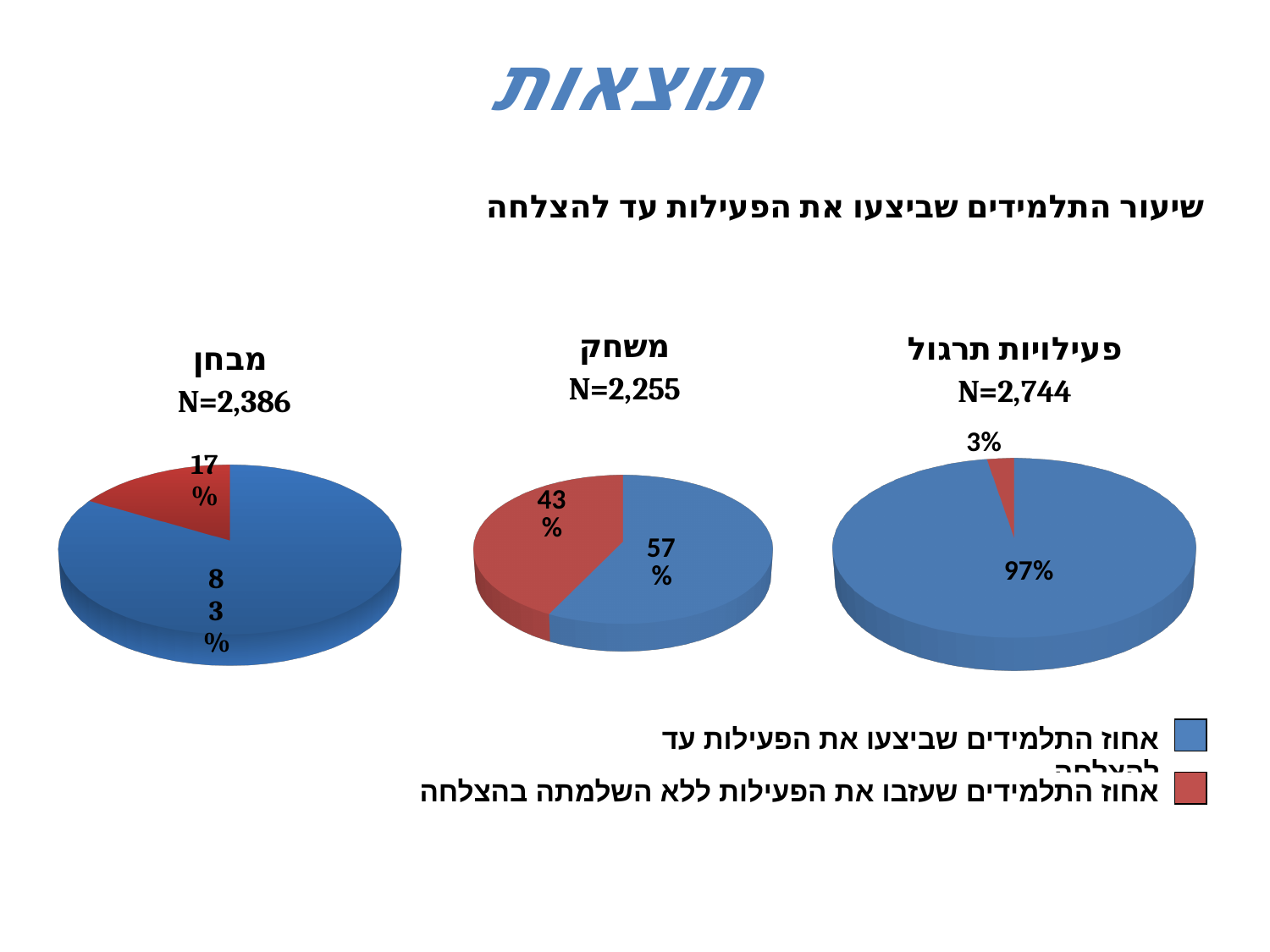
What is the sample size (N) shown for the "משחק" pie chart? N=2,255 In the "מבחן" pie chart, what share of students completed the activity successfully (blue slice)? 83% In the "משחק" pie chart, what share of students abandoned the activity (red slice)? 43% In the "פעילויות תרגול" pie chart, what share of students abandoned the activity (red slice)? 3% Which of the three pie charts shows the highest share of students who completed the activity successfully? פעילויות תרגול What is the difference between the blue and red slices in the "משחק" pie chart? 14% Which of the three pie charts shows the lowest share of students who completed the activity successfully? משחק What kind of chart is used for the "מבחן" data? pie chart How many pie charts are shown on the slide? 3